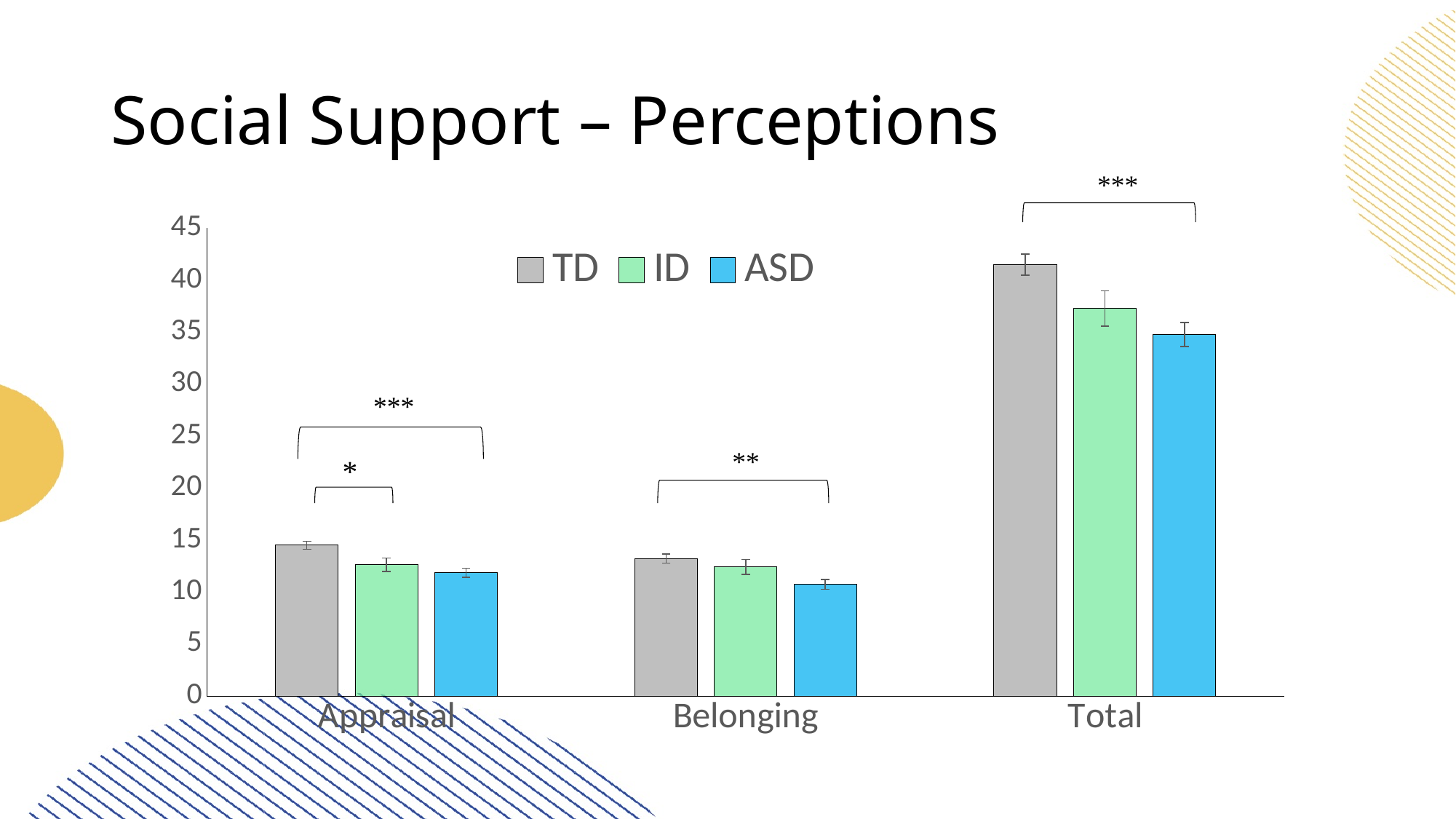
Is the value for ASD in the Appraisal category greater or less than 10? greater Which series has the lowest value in the Total category? ASD How many categories are shown on the x axis? 3 What is the title of the slide containing the chart? Social Support – Perceptions How many series does the legend list? 3 In the Total category, which is larger, TD or ASD? TD In the Belonging category, which is larger, ID or ASD? ID Is the value for ID in the Total category greater or less than 35? greater Is the value for TD in the Total category greater or less than 40? greater What kind of chart is shown on the slide? bar chart Which series are listed in the legend? TD, ID, ASD